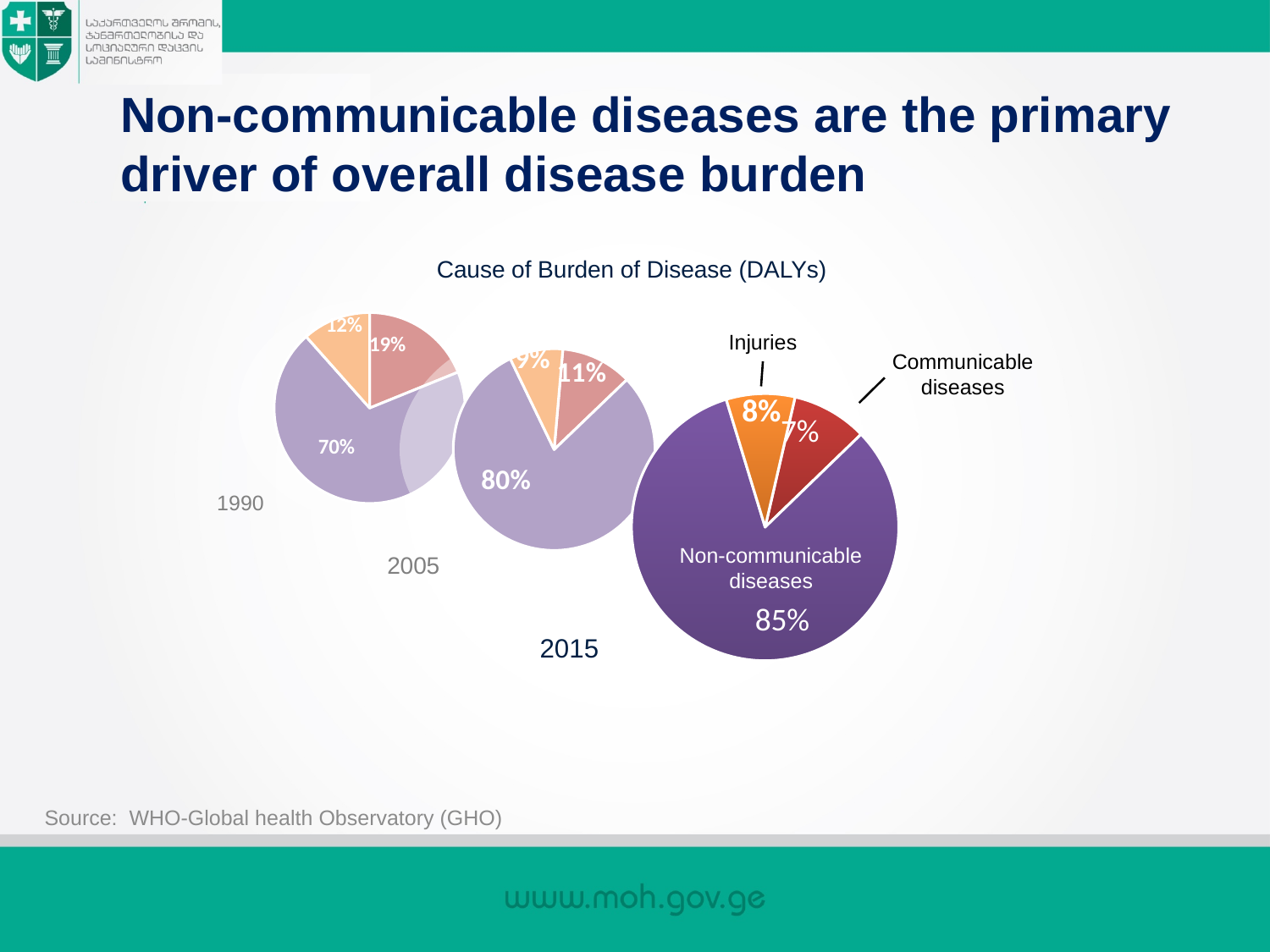
In the 1990 pie chart, what share of the disease burden is attributed to communicable diseases? 19% In the 2015 pie chart, which cause accounts for the largest share of the disease burden? Non-communicable diseases In the 2005 pie chart, what share of the disease burden is attributed to non-communicable diseases? 80% What kind of chart is used to show the cause of burden of disease for each year? Pie chart In the 2015 pie chart, what share of the disease burden is attributed to non-communicable diseases? 85% In the 1990 pie chart, what share of the disease burden is attributed to non-communicable diseases? 70% How many pie charts are shown on the slide? 3 In the 2015 pie chart, what share of the disease burden is attributed to injuries? 8% In the 2015 pie chart, which cause accounts for the smallest share of the disease burden? Communicable diseases In the 2005 pie chart, what share of the disease burden is attributed to communicable diseases? 11% In the 2015 pie chart, what share of the disease burden is attributed to communicable diseases? 7% By how many percentage points did the non-communicable disease share increase from the 1990 pie chart to the 2015 pie chart? 15 percentage points